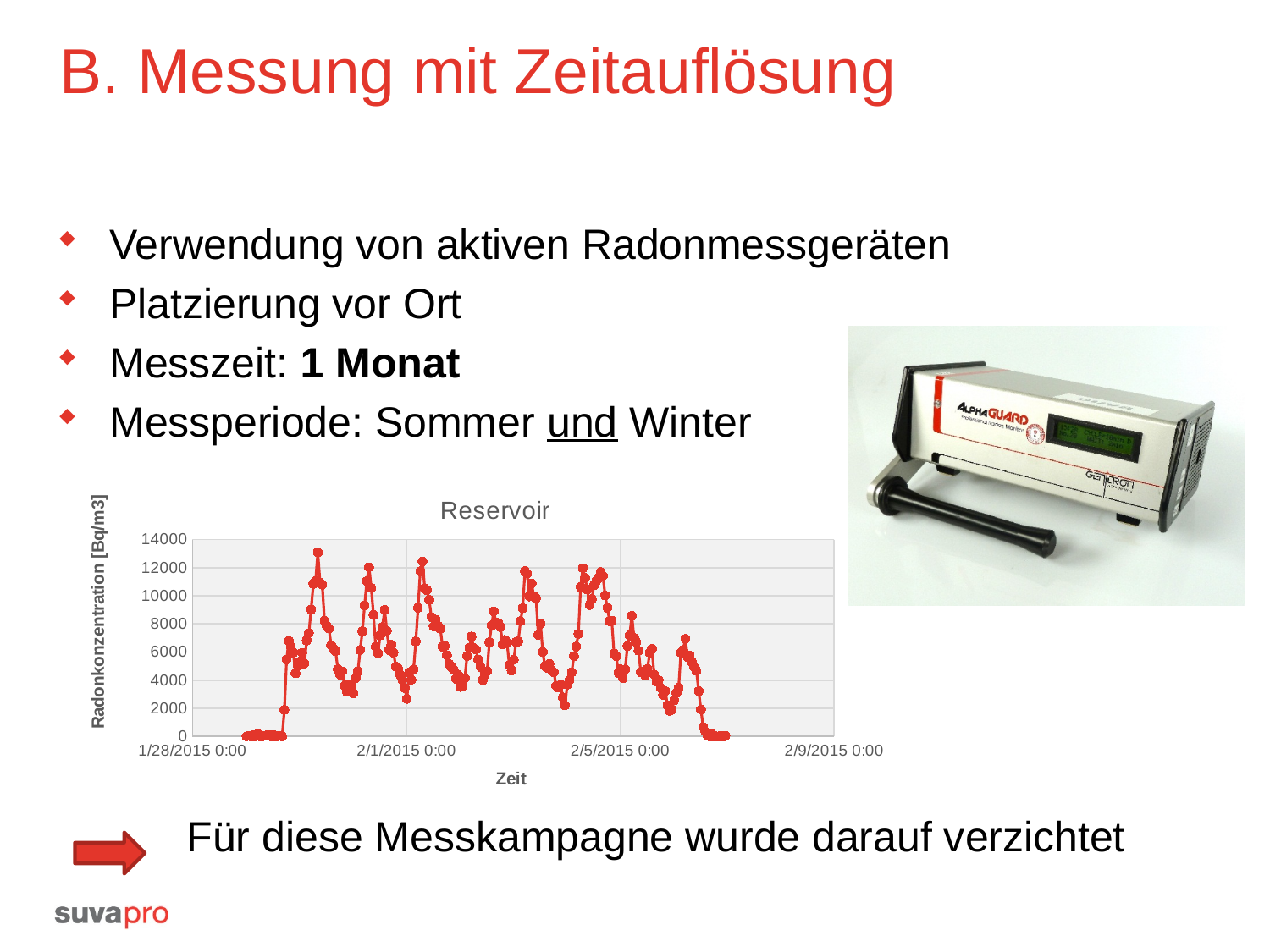
Are the radon concentration values at the very end of the measurement series (around 2/7/2015) greater or less than 2000? less Is the highest radon concentration value in the chart greater or less than 14000? less What is the last date shown on the x axis of the chart? 2/9/2015 0:00 What is the highest value shown on the y axis of the chart? 14000 How many date labels are shown on the x axis of the chart? 4 What is the title of the chart? Reservoir Is the radon concentration at the start of the series, just after 1/28/2015 0:00, greater or less than 2000? less What is the label of the y axis of the chart? Radonkonzentration [Bq/m3] What is the first date shown on the x axis of the chart? 1/28/2015 0:00 What kind of chart is shown on the slide? line chart